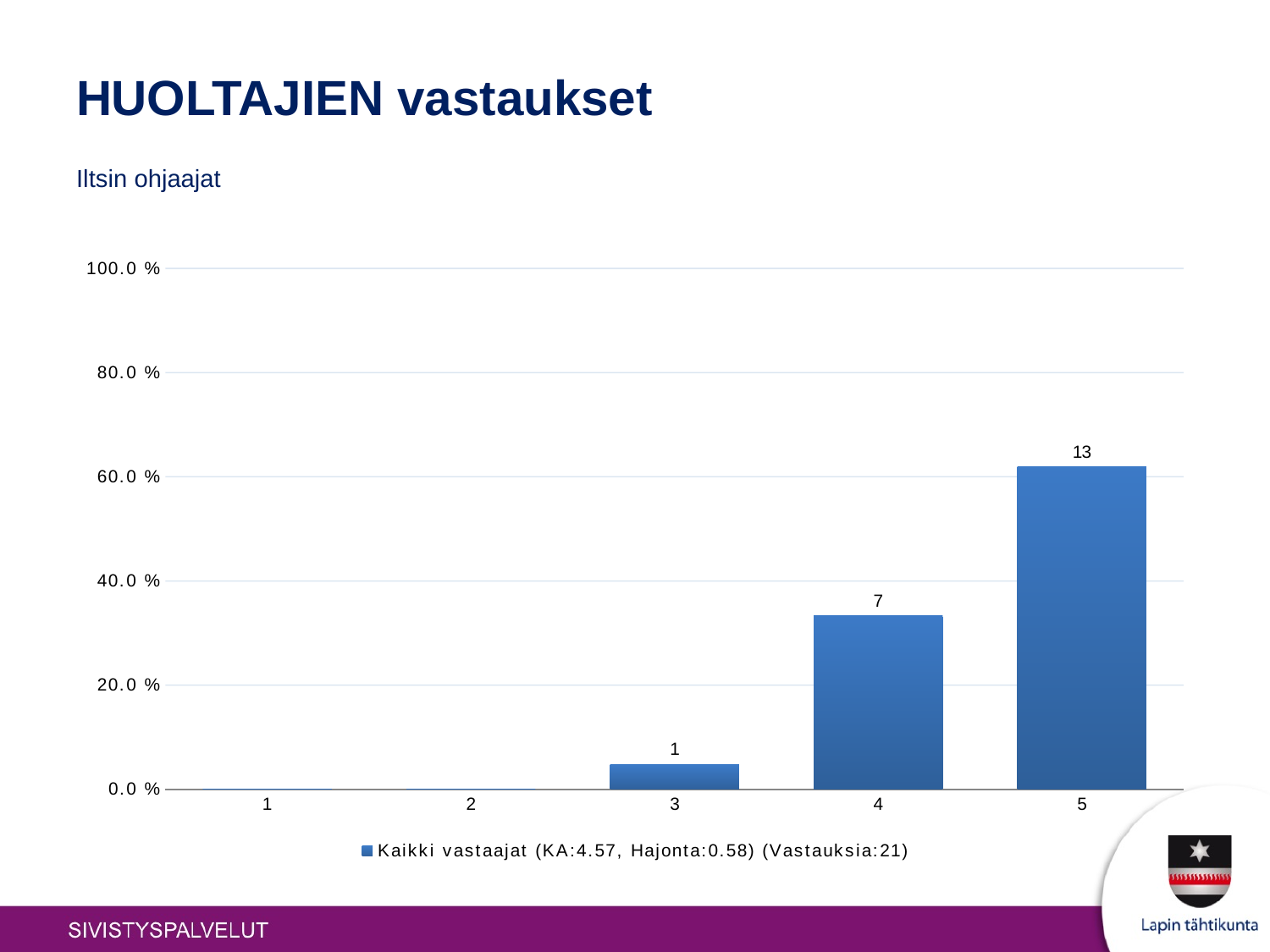
Is the value for category 4 greater or less than 40.0 %? less How many series does the legend list? 1 Is the value for category 5 greater or less than 40.0 %? greater What is the data label on the bar for category 3? 1 Which bar is taller, category 3 or category 4? 4 Is the value for category 3 greater or less than 20.0 %? less What kind of chart is shown on the slide? bar chart How many categories are shown on the x axis? 5 What is the difference between the data labels for category 5 and category 4? 6 What is the data label on the bar for category 4? 7 Which category has the highest bar? 5 What is the data label on the bar for category 5? 13